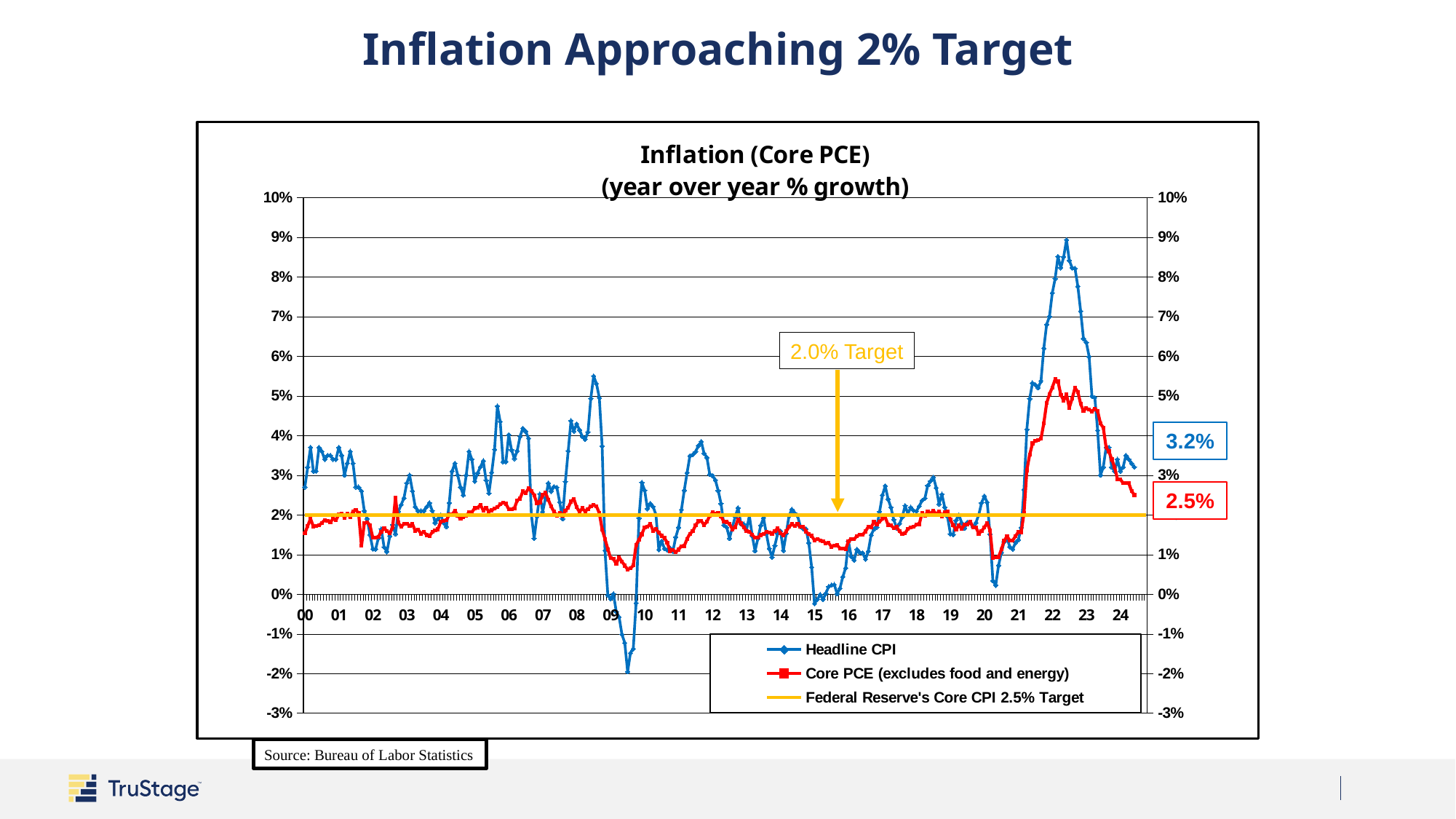
Is the lowest value of Headline CPI in 2009 greater or less than -1%? less What is the latest labeled value for Core PCE on the chart? 2.5% What kind of chart is shown on the slide? Line chart Does Headline CPI rise or fall from its 2022 peak to the end of the chart in 2024? Fall How many series does the chart legend list? 3 What is the difference between the latest labeled Headline CPI value (3.2%) and the latest labeled Core PCE value (2.5%)? 0.7 percentage points What value does the yellow horizontal line on the chart mark, according to its callout label? 2.0% Target Which series reaches the highest value anywhere on the chart? Headline CPI Is the peak value of Headline CPI in 2022 greater or less than 8%? greater Is the peak value of Core PCE in 2022 greater or less than 5%? greater What is the latest labeled value for Headline CPI on the chart? 3.2% Which is larger at the end of the chart, the labeled Headline CPI value or the labeled Core PCE value? Headline CPI